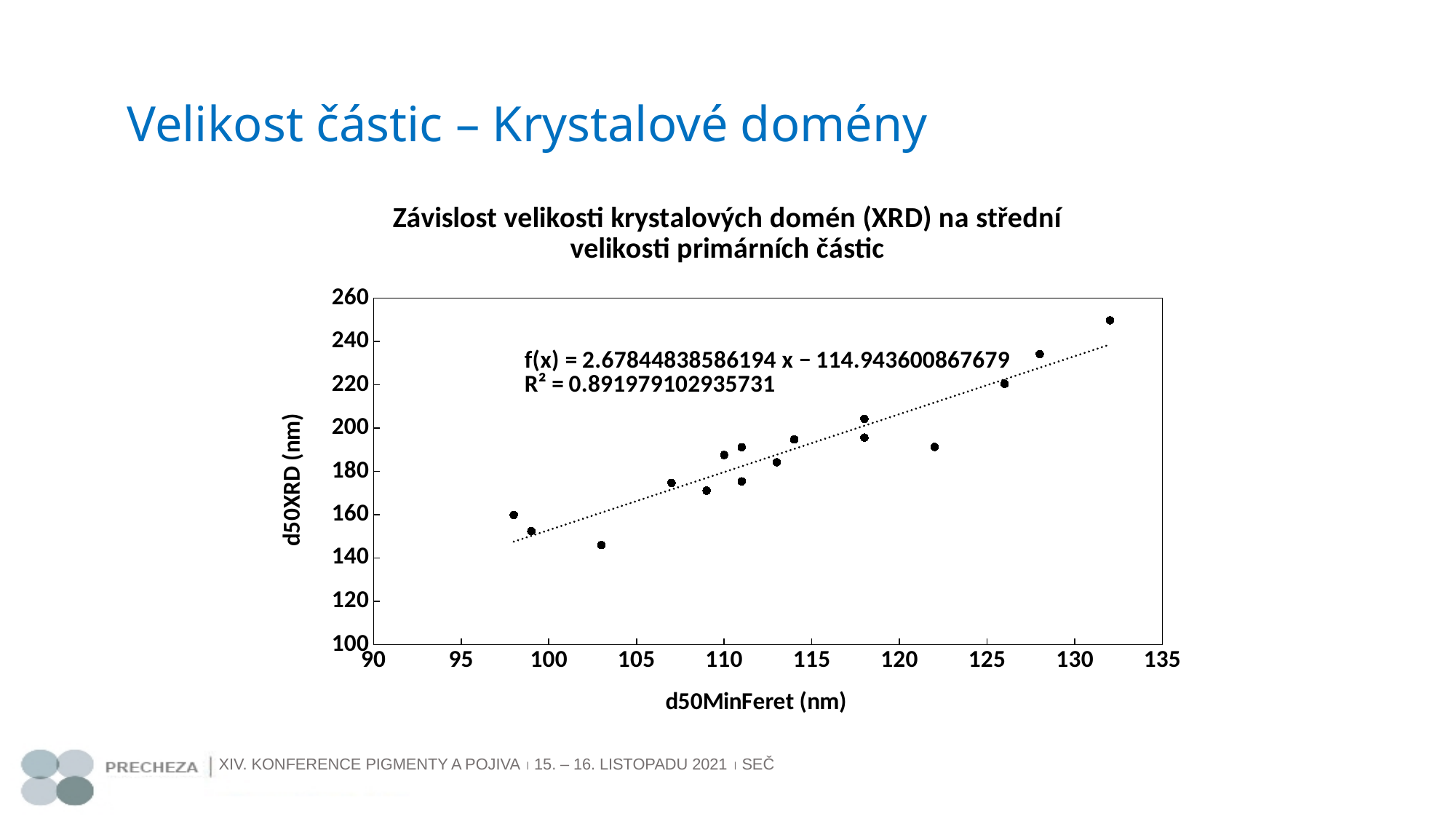
Do the d50XRD values generally rise or fall as d50MinFeret increases? rise Is the d50XRD value of the lowest point (at d50MinFeret ≈ 103 nm) greater or less than 160? less What is the label of the y axis? d50XRD (nm) Which has the larger d50XRD value: the point at d50MinFeret ≈ 126 nm or the point at ≈ 122 nm? the point at ≈ 126 nm What kind of chart is shown on the slide? scatter chart What is the slope of the fitted line f(x) printed on the chart? 2.67844838586194 Is the d50XRD value of the point at d50MinFeret ≈ 132 nm greater or less than 240? greater Which point has the highest d50XRD value: the one at d50MinFeret ≈ 132 nm or the one at ≈ 98 nm? the one at ≈ 132 nm What is the R² value printed on the chart? 0.891979102935731 What is the maximum value shown on the x axis? 135 Is the d50XRD value of the point at d50MinFeret ≈ 128 nm greater or less than 220? greater What is the title of the chart? Závislost velikosti krystalových domén (XRD) na střední velikosti primárních částic